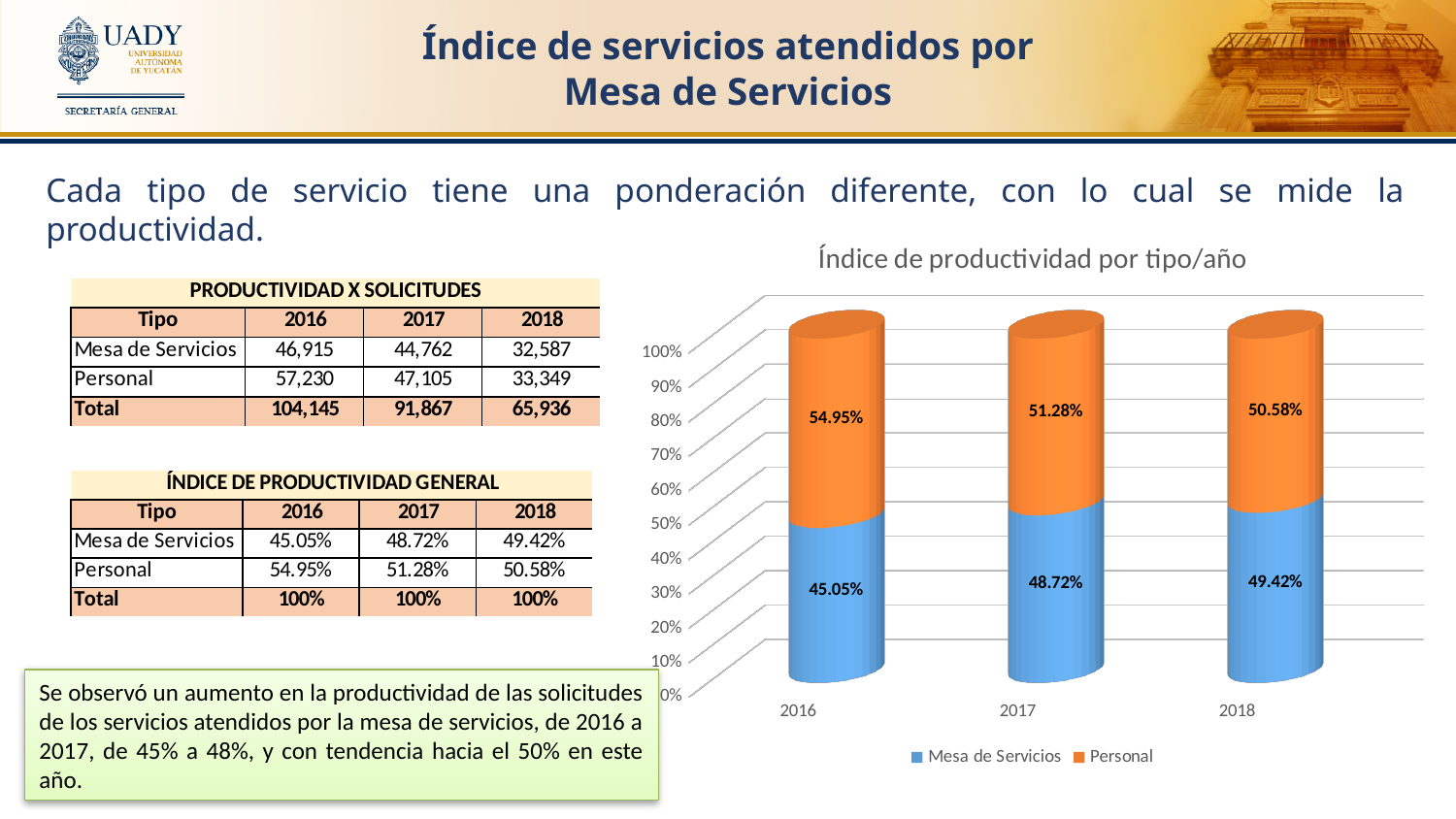
In which year is the Personal value lowest? 2018 Which is larger in 2017, the Mesa de Servicios value or the Personal value? Personal What is the value for Personal in 2018? 50.58% What is the value for Personal in 2017? 51.28% What is the difference between the Personal value and the Mesa de Servicios value in 2016? 9.90% What is the value for Mesa de Servicios in 2018? 49.42% How many years are shown on the x axis? 3 In which year is the Mesa de Servicios value highest? 2018 How many series does the legend list? 2 Does the Mesa de Servicios value rise or fall from 2016 to 2018? Rise What is the value for Mesa de Servicios in 2016? 45.05% What kind of chart is shown? Stacked bar chart